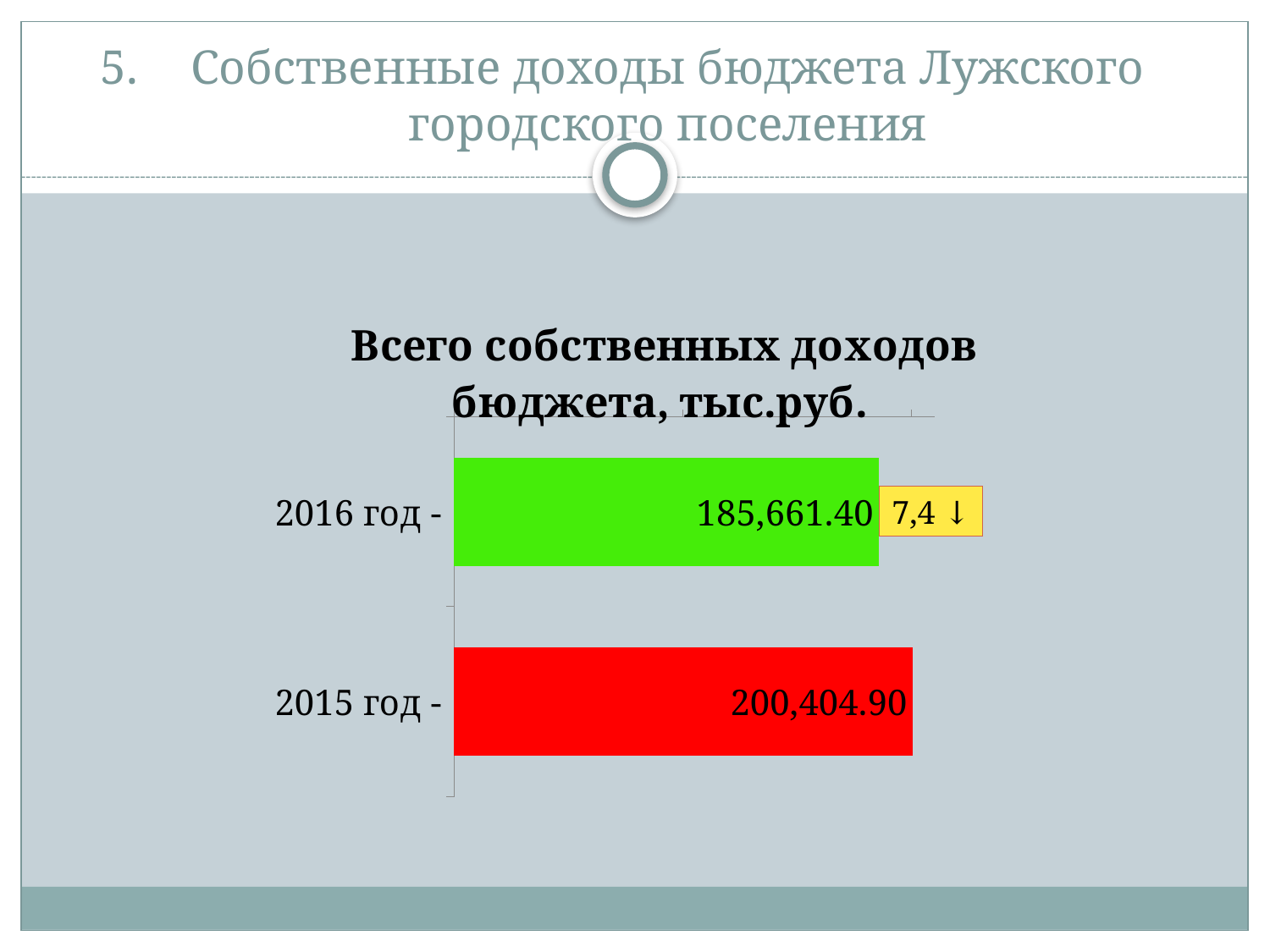
What colour is the bar for 2015 год? red What is the difference between the values for 2015 год and 2016 год? 14,743.50 What is the value for 2015 год in the chart "Всего собственных доходов бюджета, тыс.руб."? 200,404.90 Is the value for 2016 год larger or smaller than the value for 2015 год? smaller What is the value for 2016 год in the chart "Всего собственных доходов бюджета, тыс.руб."? 185,661.40 Which year has the higher value of total own budget revenues? 2015 год How many categories (years) are shown in the chart? 2 Which year has the lower value of total own budget revenues? 2016 год What percentage change is shown in the yellow box next to the 2016 год bar? 7,4 ↓ What is the title of the chart? Всего собственных доходов бюджета, тыс.руб. What type of chart is shown on the slide? bar chart